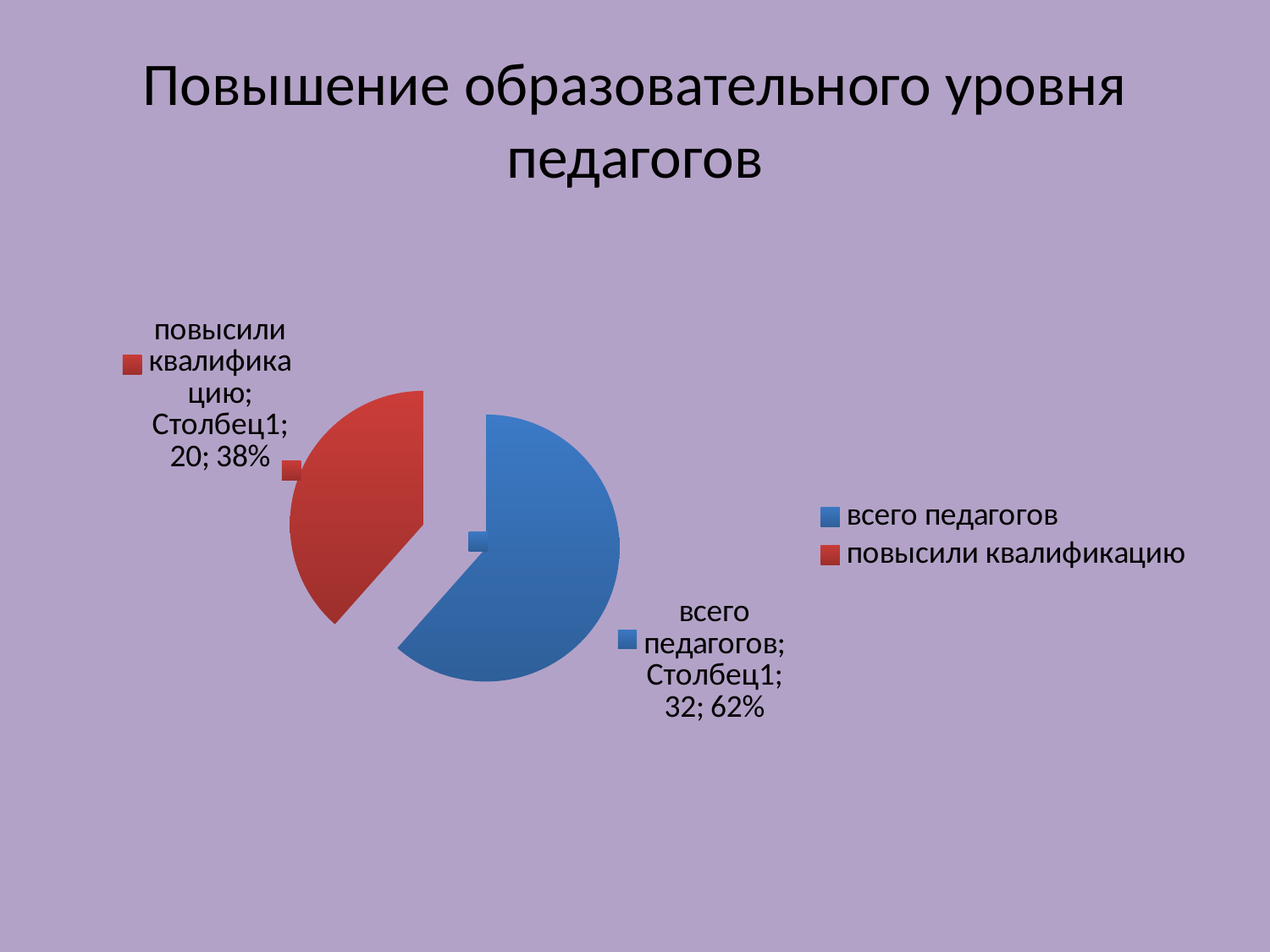
Which slice is the smallest? повысили квалификацию How many slices does the pie chart have? 2 What share of the pie does "повысили квалификацию" take? 38% What is the value for "повысили квалификацию"? 20 What type of chart is shown on the slide? pie chart How many entries does the legend list? 2 Which is larger: "всего педагогов" or "повысили квалификацию"? всего педагогов What share of the pie does "всего педагогов" take? 62% What colour is the slice for "повысили квалификацию"? red What is the difference between the values for "всего педагогов" and "повысили квалификацию"? 12 What is the value for "всего педагогов"? 32 Which slice is the largest? всего педагогов